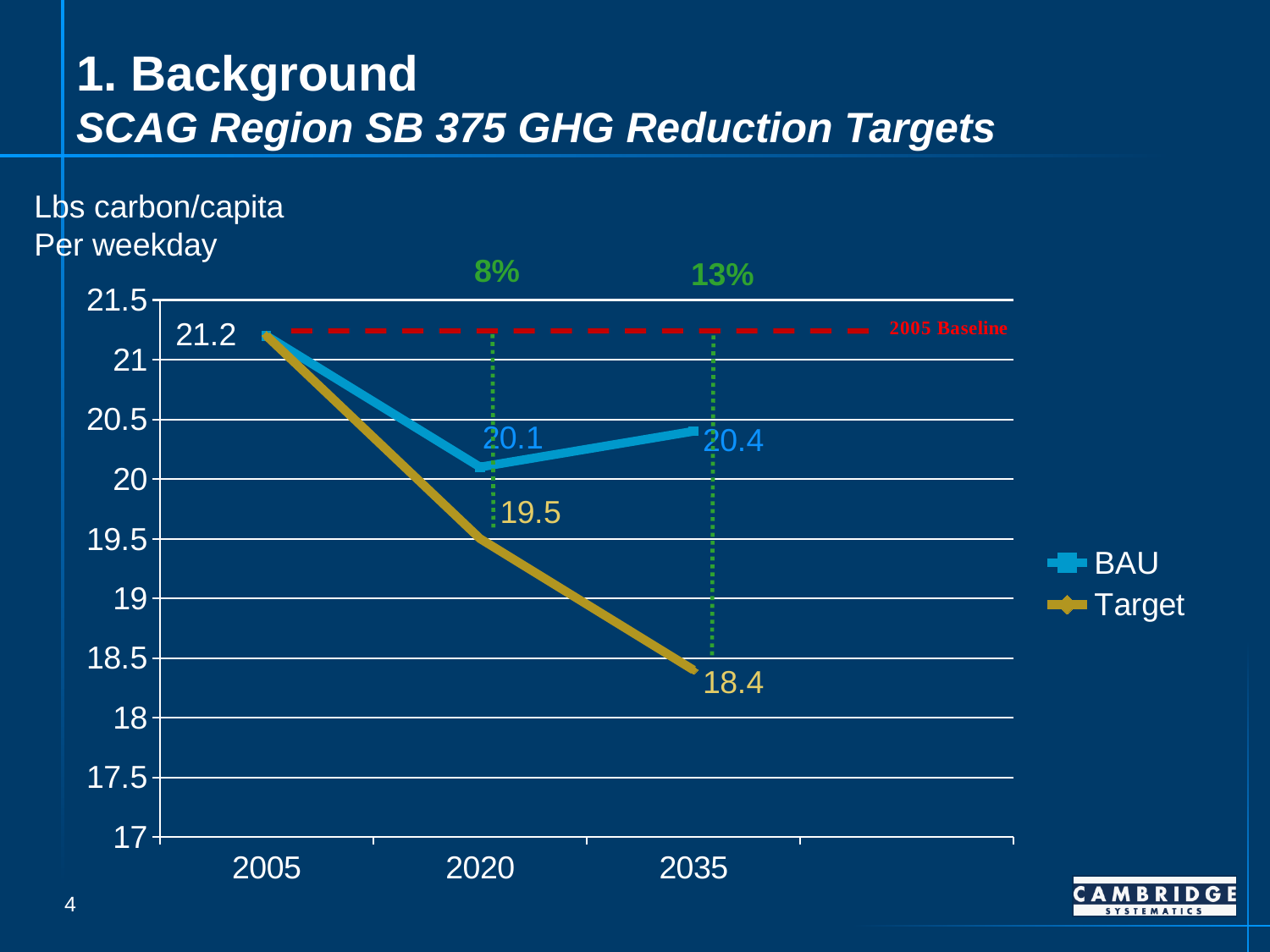
What type of chart is shown on the slide? line chart What is the BAU value in 2020? 20.1 Which series has the higher value in 2035, BAU or Target? BAU What is the difference between the BAU and Target values in 2020? 0.6 Does the Target series rise or fall from 2005 to 2035? fall How many years are labelled on the x axis? 3 What percentage reduction is labelled above the 2035 point? 13% What is the Target value in 2035? 18.4 What is the Target value in 2020? 19.5 How many series does the legend list? 2 What is the value shown for 2005? 21.2 What is the difference between the BAU and Target values in 2035? 2.0